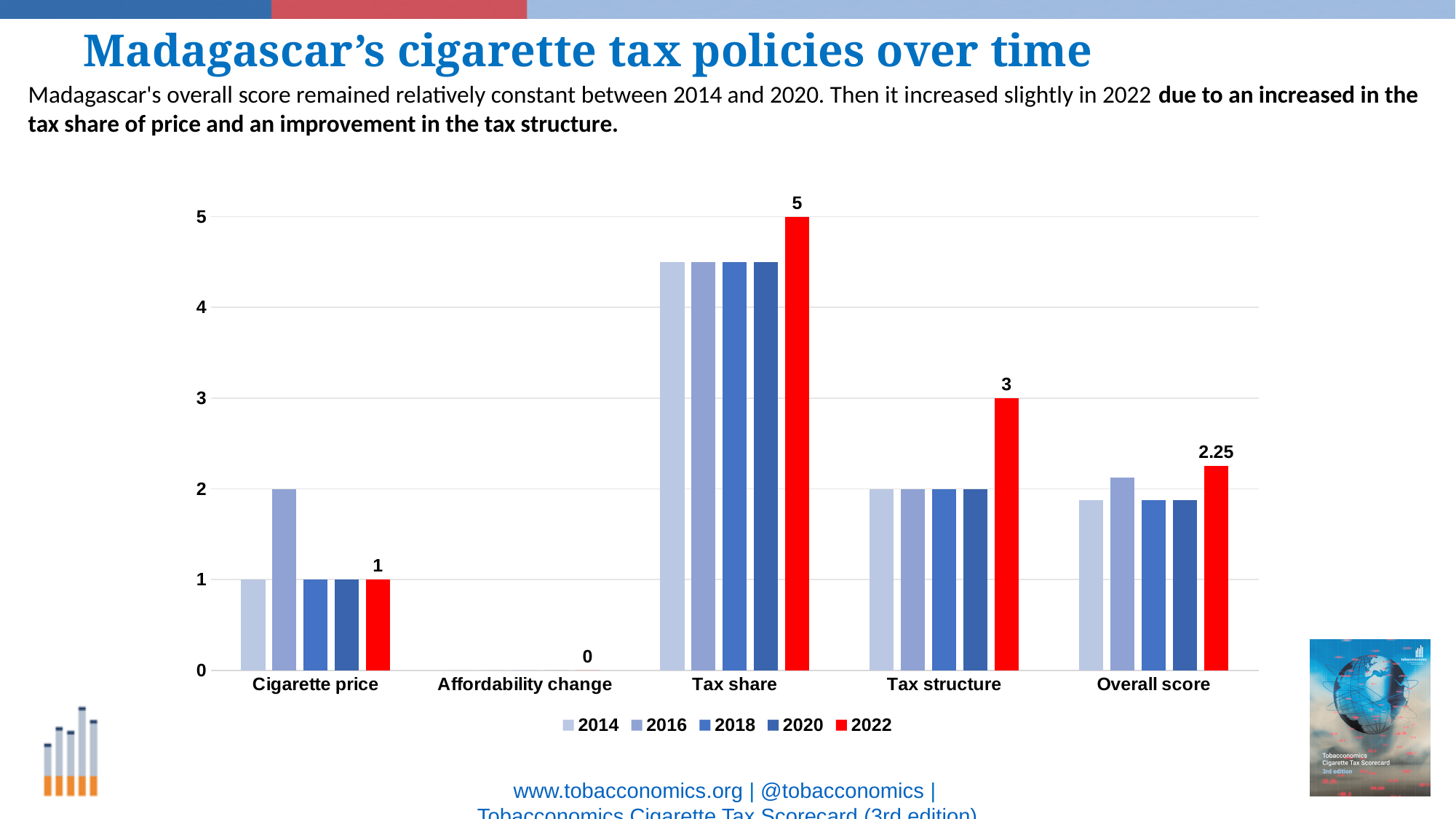
How many series does the legend list? 5 Is the value for Tax share in 2014 greater or less than 4? greater What is the value for Cigarette price in 2016? 2 What kind of chart is shown on the slide? bar chart What is the Overall score for 2022? 2.25 What is the difference between the 2022 values for Tax share and Tax structure? 2 Which is larger in 2022: Tax structure or Overall score? Tax structure What is the value for Tax share in 2022? 5 What is the value for Tax structure in 2022? 3 How many categories are shown on the x axis? 5 What is the value for Affordability change in 2022? 0 Which category has the highest value in 2022? Tax share